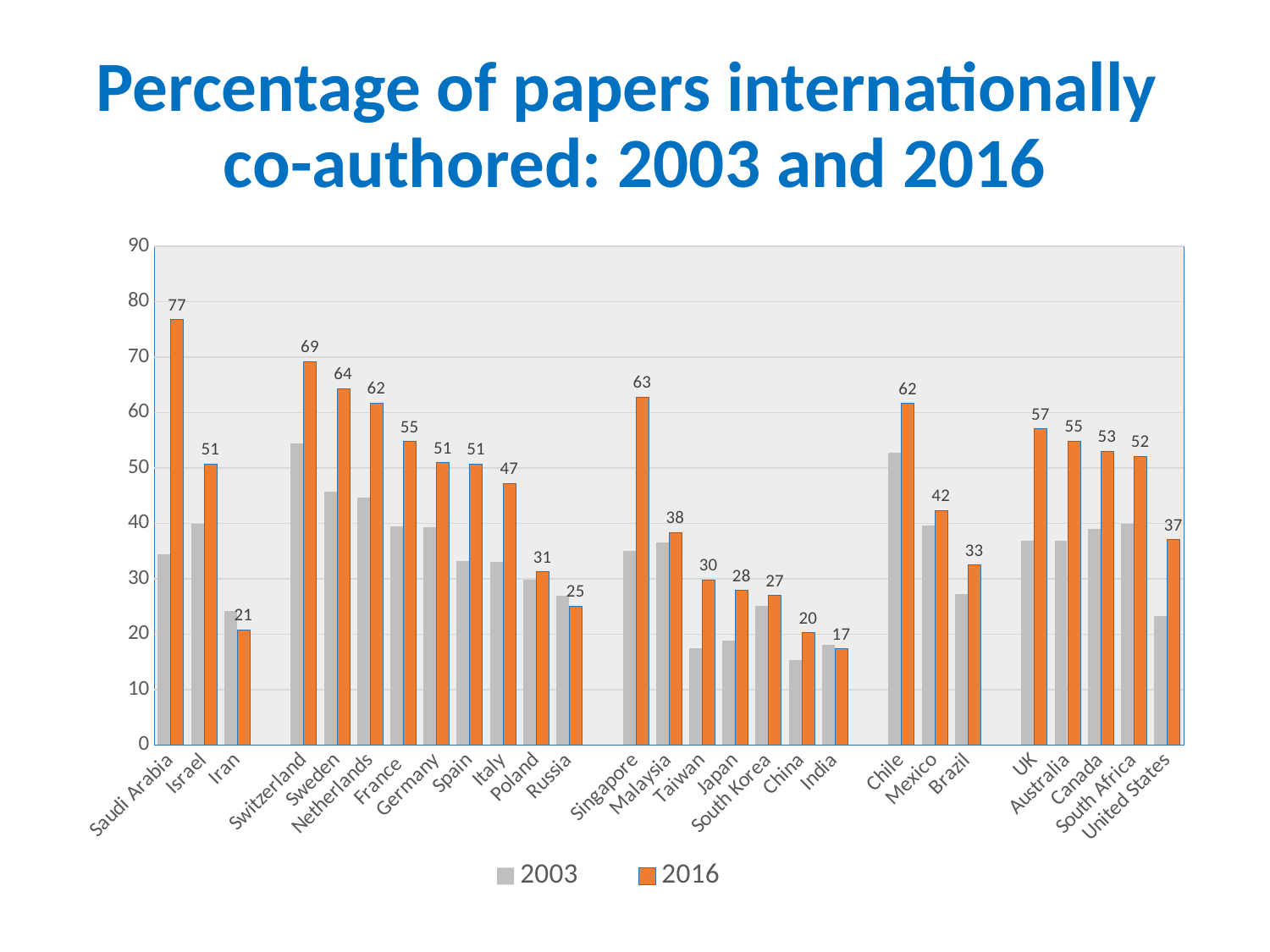
What is the 2016 value for Singapore? 63 How many countries are shown on the x axis? 27 Which country has the highest 2016 value? Saudi Arabia What kind of chart is shown on the slide? Bar chart Which country has the lowest 2016 value? India Is the 2003 value for the United States greater or less than 30? less Is the 2003 value for Switzerland greater or less than 50? greater What is the 2016 value for Saudi Arabia? 77 What is the difference between the 2016 values for Switzerland and Sweden? 5 What is the 2016 value for the United States? 37 Which has a larger 2016 value, Chile or Mexico? Chile How many series does the legend list? 2